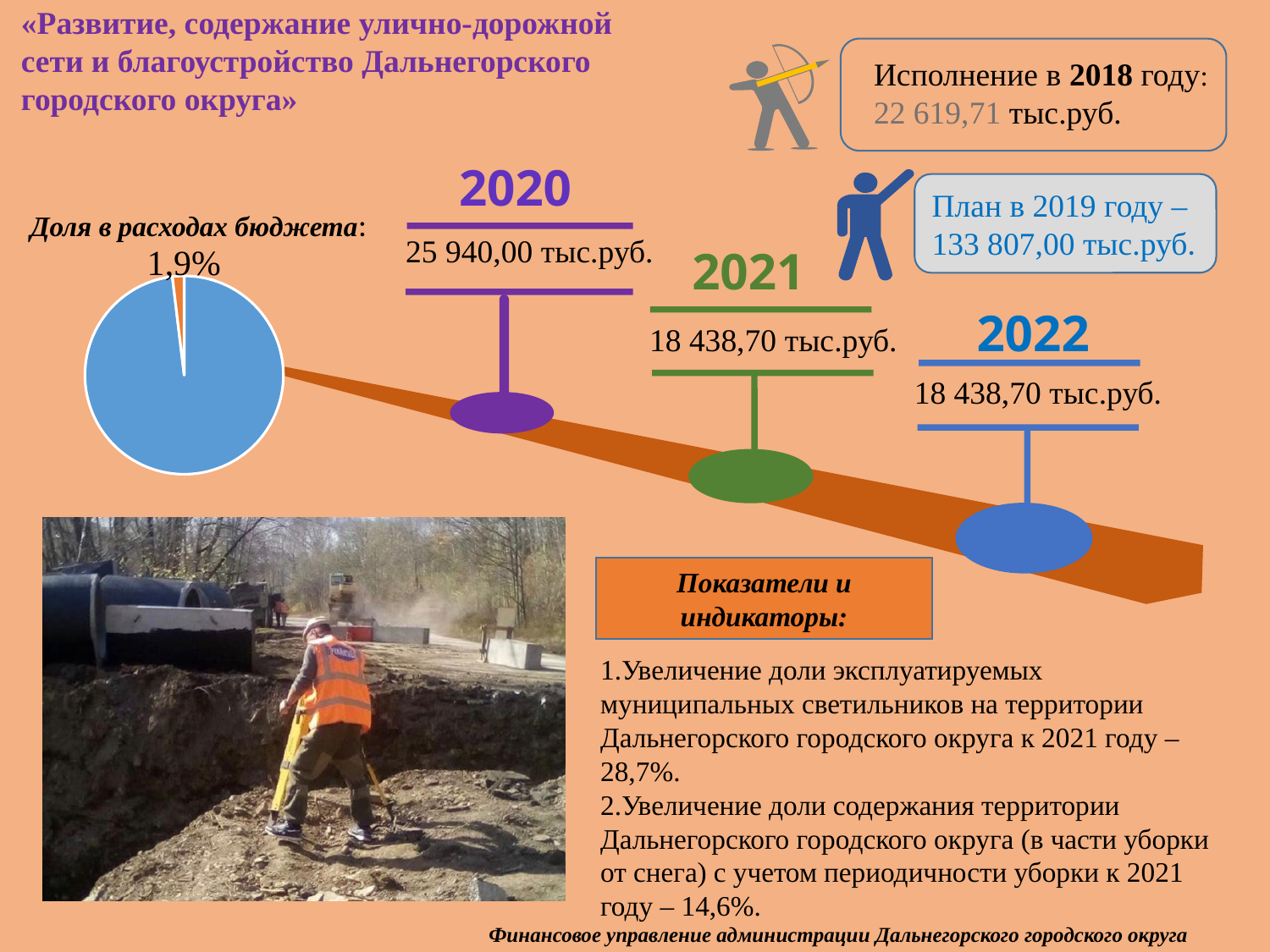
How many slices does the pie chart have? 2 What colour is the small slice labelled 1,9% in the pie chart? orange Which slice of the pie chart is larger, the blue one or the orange one? the blue one What share does the labelled slice of the pie chart represent? 1,9% What kind of chart is shown under the heading «Доля в расходах бюджета»? pie chart What is the heading printed above the pie chart? Доля в расходах бюджета Is the share shown by the labelled slice of the pie chart greater or less than 50%? less